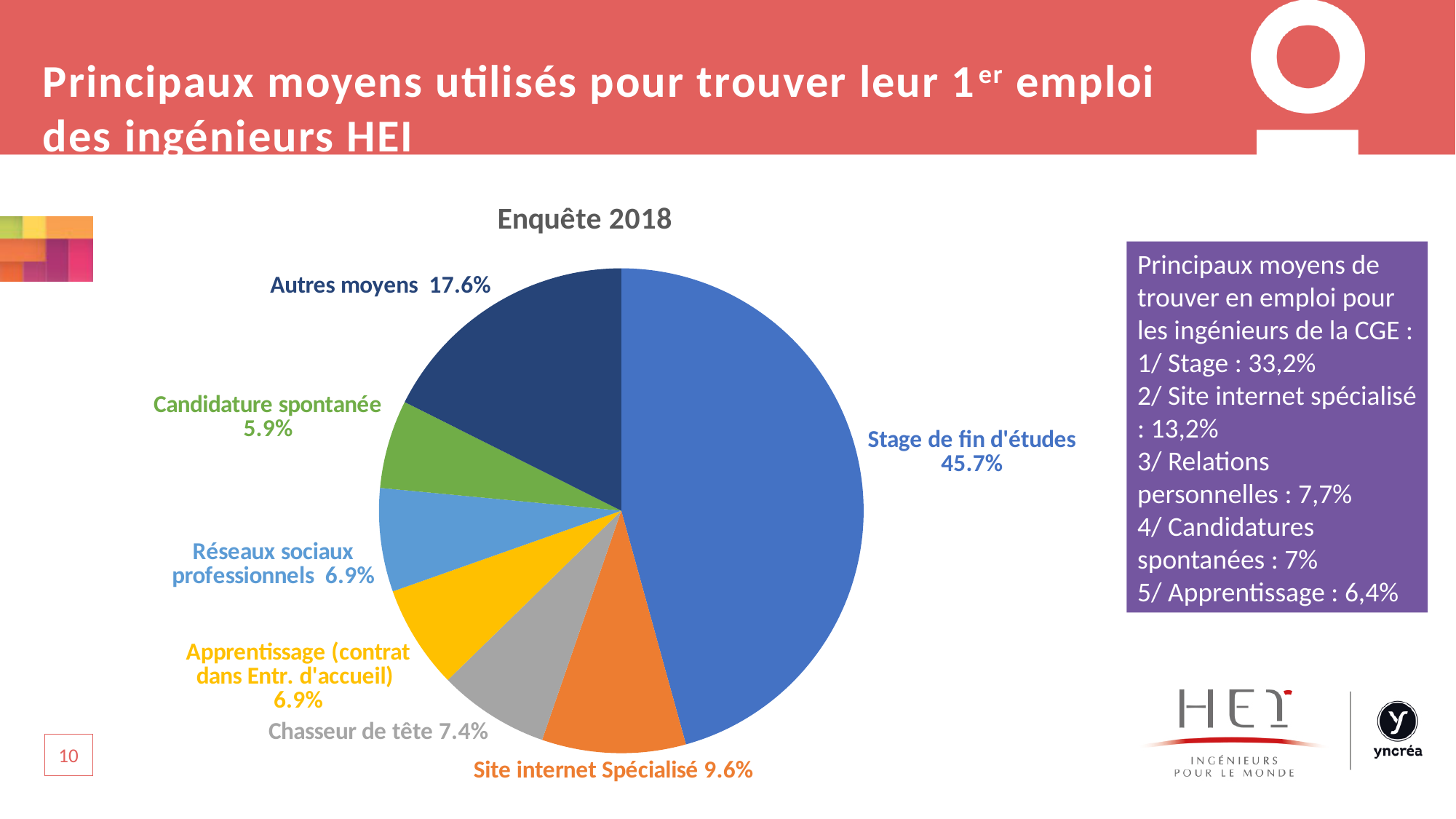
What is the value shown for "Chasseur de tête"? 7.4% What colour is the slice for "Site internet Spécialisé"? Orange What is the difference between the values for "Stage de fin d'études" and "Autres moyens"? 28.1% Which is larger, the value for "Chasseur de tête" or the value for "Candidature spontanée"? Chasseur de tête What is the title of the chart? Enquête 2018 Which category has the smallest slice of the pie? Candidature spontanée What is the value shown for "Site internet Spécialisé"? 9.6% What share of the pie does "Stage de fin d'études" represent? 45.7% How many slices does the pie chart have? 7 What type of chart is shown on the slide? Pie chart What is the value shown for "Autres moyens"? 17.6% Which category has the largest slice of the pie? Stage de fin d'études